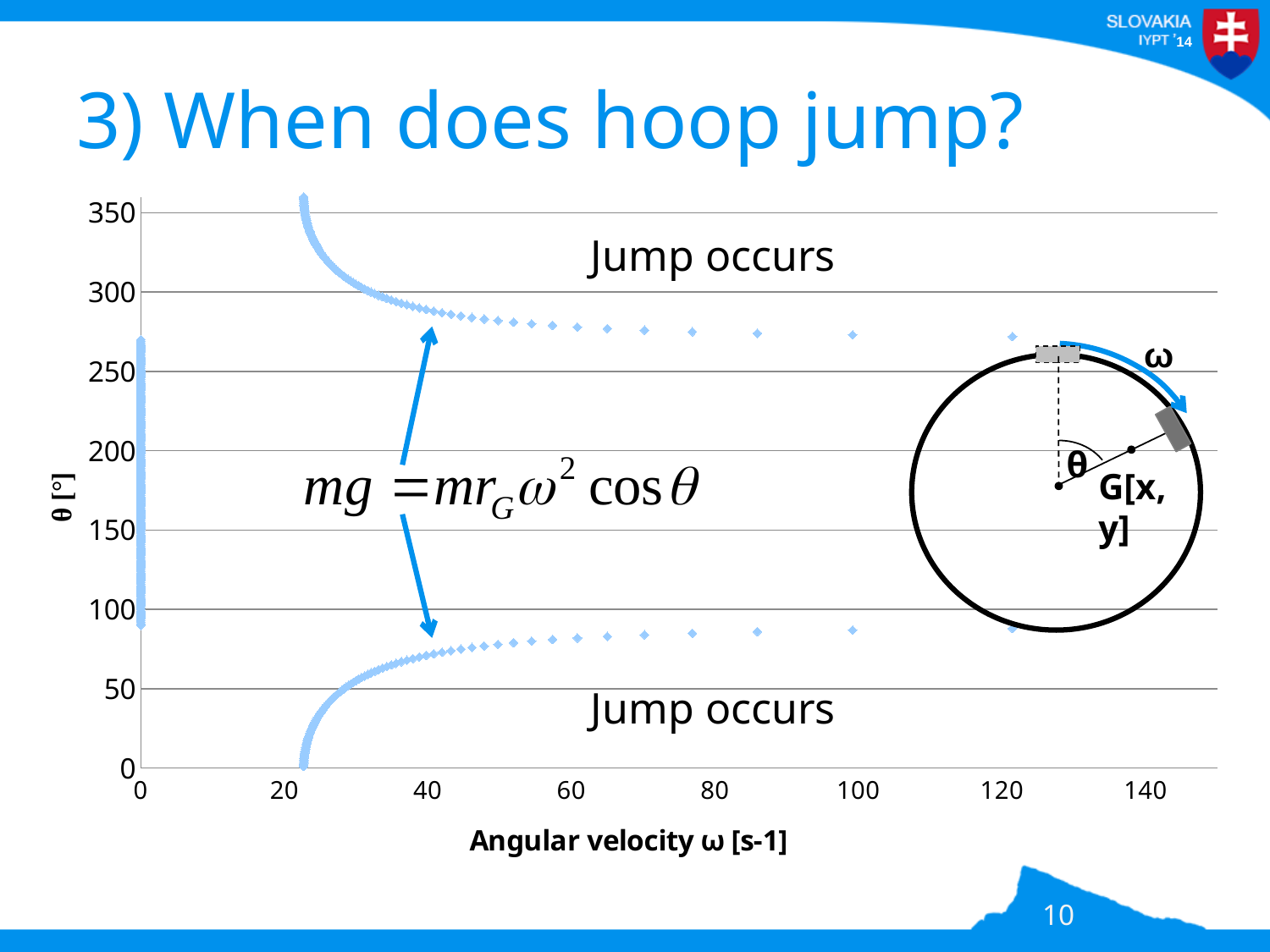
What is the highest tick value shown on the x axis? 140 Is the angular velocity at which the two curved branches begin greater or less than 20? greater Is the θ value of the upper branch at an angular velocity of 40 greater or less than 250? greater What kind of chart is shown on the slide? scatter chart Does the θ value of the upper branch of points rise or fall as angular velocity increases? fall Is the θ value of the upper branch of points at an angular velocity of 100 greater or less than 250? greater What is the highest tick value shown on the y axis? 350 Does the θ value of the lower branch of points rise or fall as angular velocity increases? rise What is the label of the y axis of the chart? θ [°] What is the label of the x axis of the chart? Angular velocity ω [s-1]